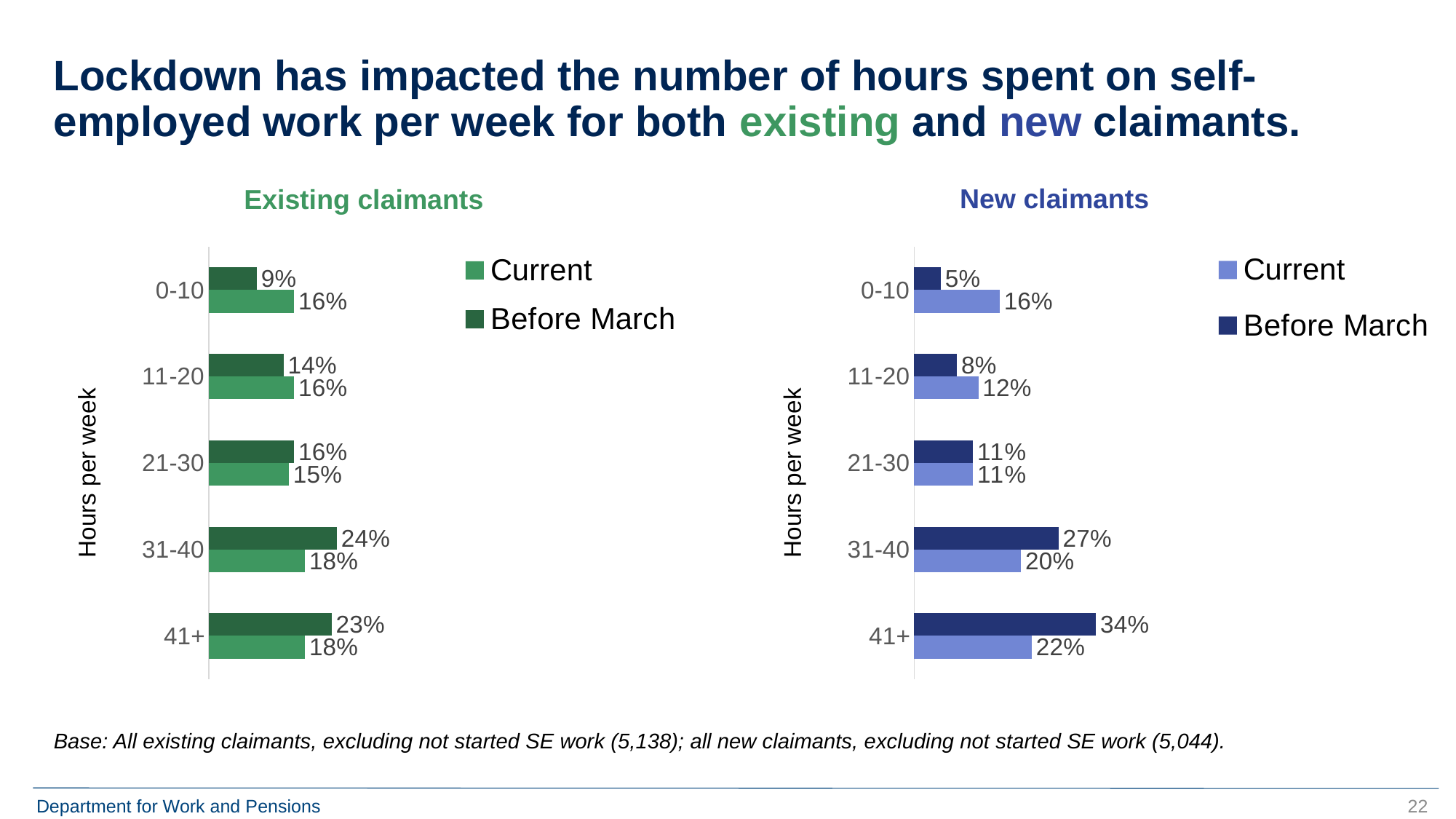
In the New claimants chart, what is the Before March value for 0-10 hours per week? 5% How many series does the legend of the Existing claimants chart list? 2 In the New claimants chart, what is the Current value for 41+ hours per week? 22% What are the two series listed in the legend of the New claimants chart? Current and Before March In the Existing claimants chart, what is the Before March value for 31-40 hours per week? 24% In the Existing claimants chart, which is larger for 21-30 hours per week: the Current value or the Before March value? Before March In the New claimants chart, what is the difference between the Before March and Current values for 41+ hours per week? 12% How many hours-per-week categories are shown in the New claimants chart? 5 In the New claimants chart, which hours-per-week category has the highest Before March value? 41+ In the Existing claimants chart, what is the difference between the Current and Before March values for 0-10 hours per week? 7% In the Existing claimants chart, which hours-per-week category has the lowest Before March value? 0-10 What type of chart is the New claimants chart? Bar chart